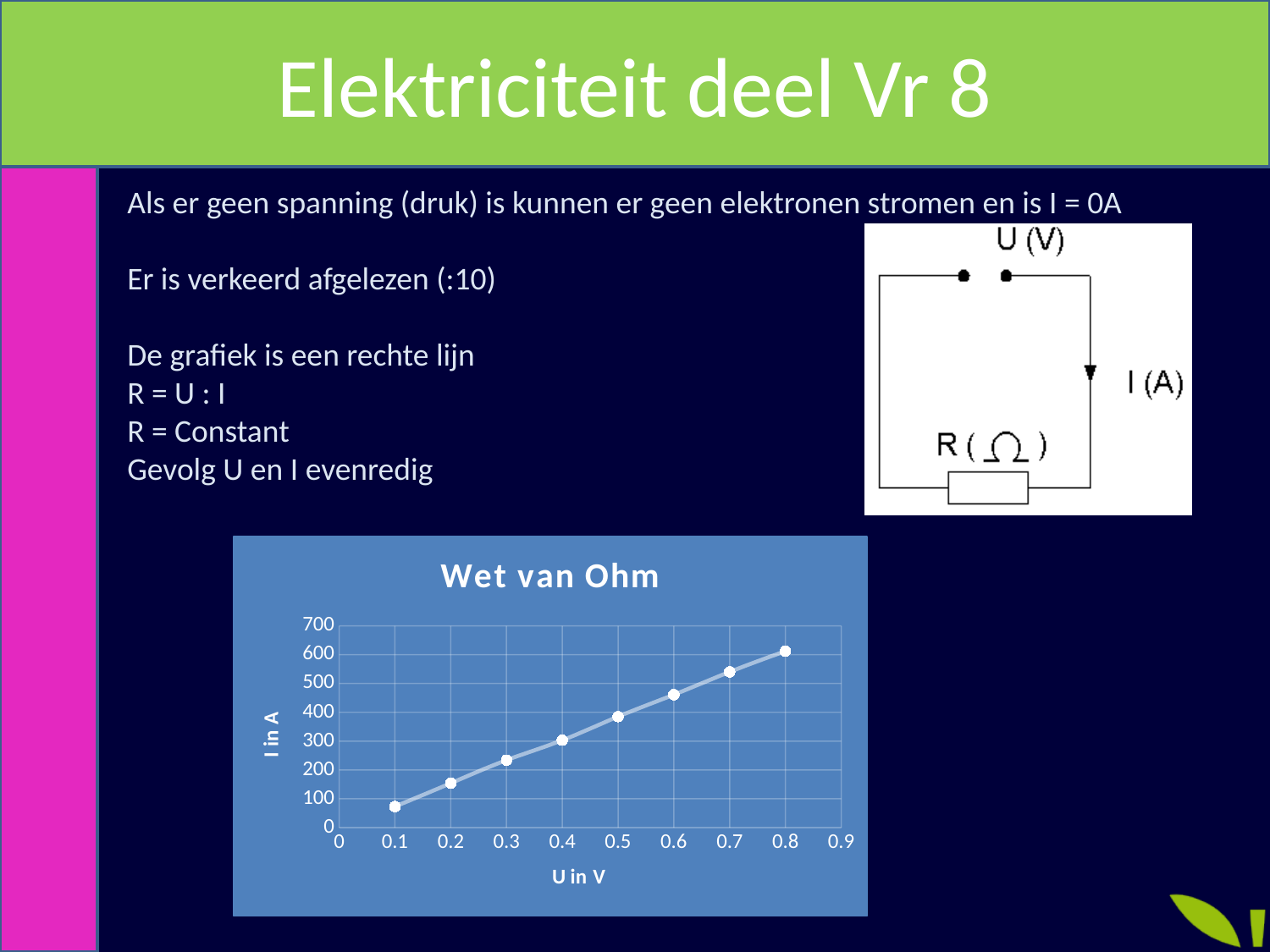
What kind of chart is shown on the slide? line chart Is the value of I at U = 0.7 V greater or less than 500? greater Which has the larger value of I: U = 0.2 V or U = 0.6 V? 0.6 V At which value of U in V is I in A highest? 0.8 What is the label of the y axis? I in A Is the value of I at U = 0.3 V greater or less than 200? greater What is the title of the chart? Wet van Ohm Is the value of I at U = 0.1 V greater or less than 100? less How many data points are plotted on the chart? 8 At which value of U in V is I in A lowest? 0.1 Do the values of I rise or fall as U increases along the x axis? rise